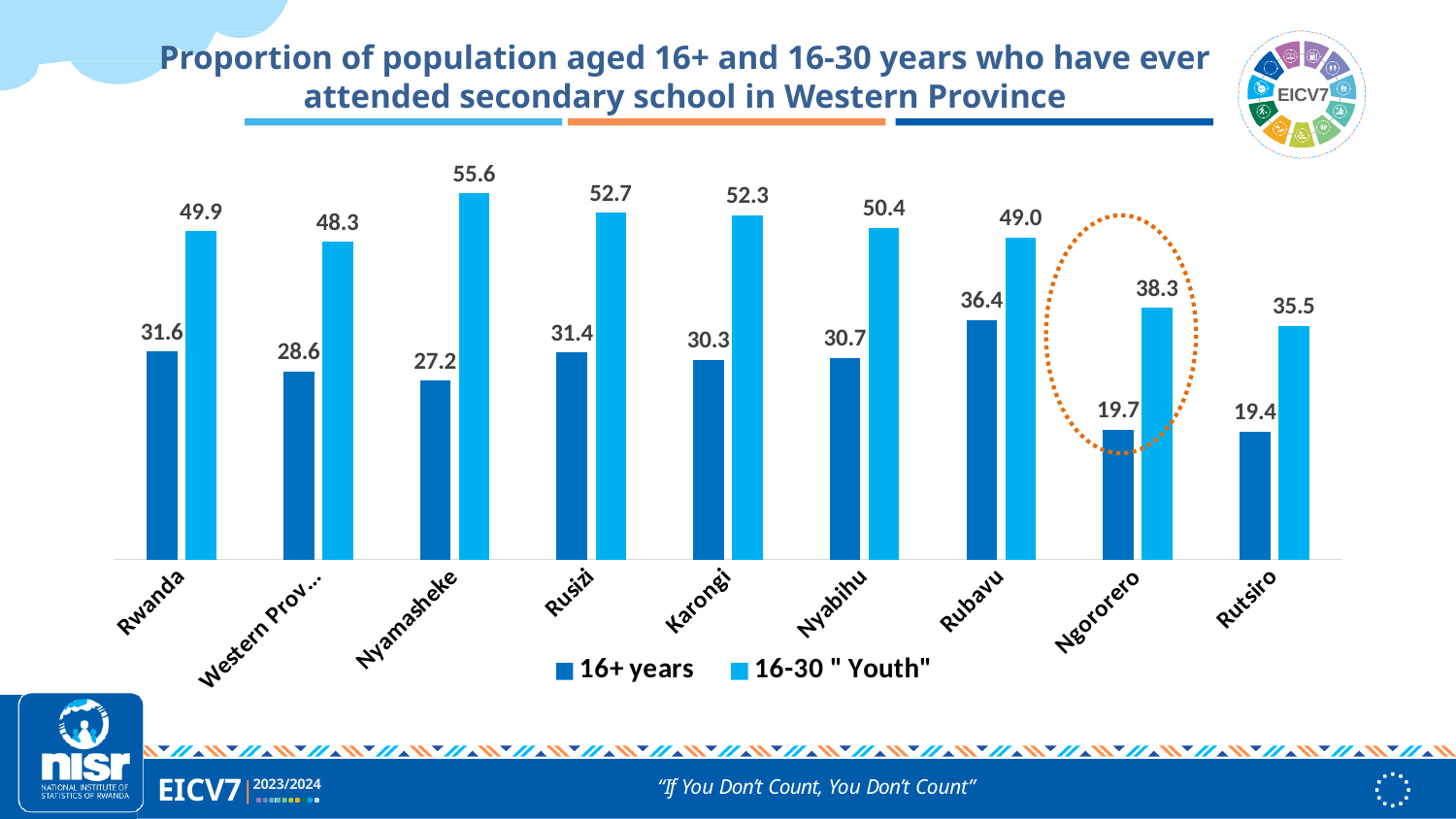
Which category has the highest value in the 16-30 "Youth" series? Nyamasheke What is the difference between the 16-30 "Youth" value and the 16+ years value for Ngororero? 18.6 Which category has the lowest value in the 16+ years series? Rutsiro What kind of chart is shown on the slide? Bar chart How many categories are shown on the x axis? 9 Which has a larger 16+ years value, Rusizi or Karongi? Rusizi What is the value for the 16+ years series for Rubavu? 36.4 Which category has the highest value in the 16+ years series? Rubavu What is the difference between the 16-30 "Youth" value and the 16+ years value for Rwanda? 18.3 What is the value for the 16-30 "Youth" series for Nyabihu? 50.4 What is the value for the 16-30 "Youth" series for Nyamasheke? 55.6 How many series does the legend list? 2